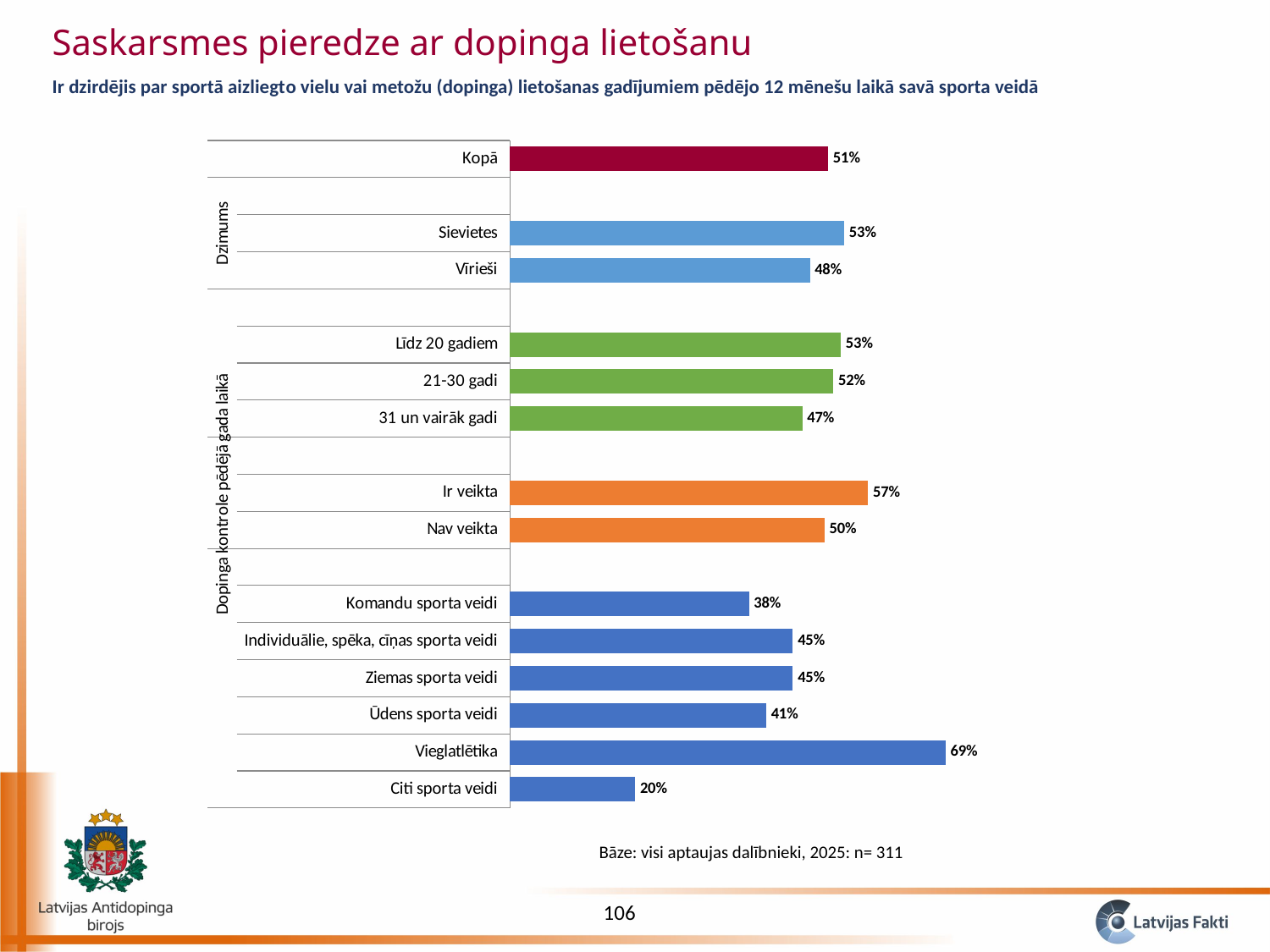
How many bars are plotted in the chart? 14 What is the value for Vieglatlētika? 69% What is the value for Komandu sporta veidi? 38% What is the difference between the values for Sievietes and Vīrieši? 5% What is the difference between the values for Ir veikta and Nav veikta? 7% What is the value for Kopā? 51% Which is larger, the value for Līdz 20 gadiem or the value for 31 un vairāk gadi? Līdz 20 gadiem What is the base (n) stated below the chart? n= 311 Which category has the lowest value? Citi sporta veidi What is the value for Ir veikta? 57% What kind of chart is shown on the slide? Bar chart Which category has the highest value? Vieglatlētika